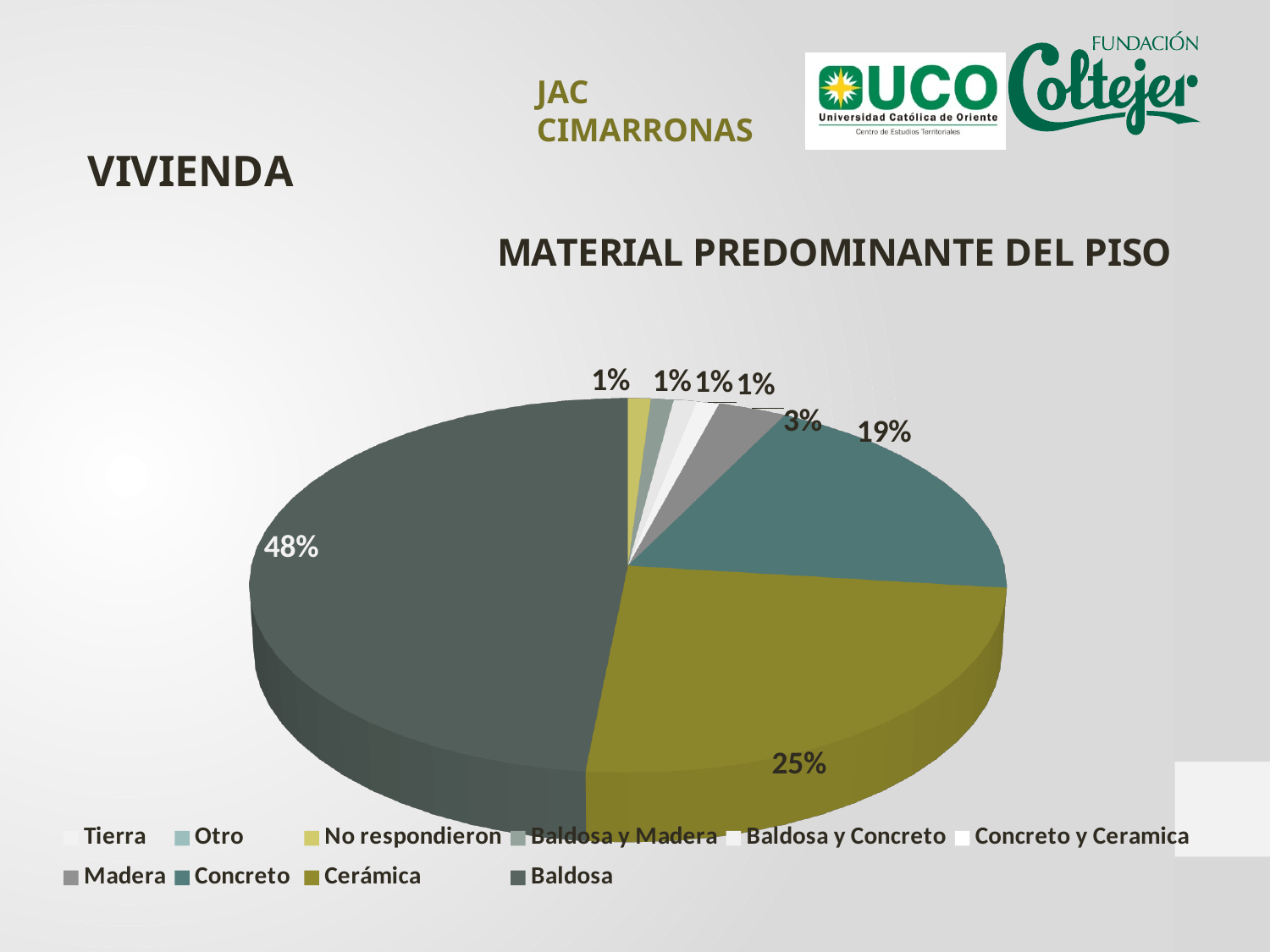
What kind of chart is shown on the slide? pie chart Which category has the largest slice of the pie? Baldosa What share of the pie does Madera account for? 3% What share of the pie does Concreto account for? 19% What is the difference in percentage points between the Baldosa slice and the Cerámica slice? 23 percentage points What share of the pie does Baldosa account for? 48% How many categories does the legend list? 10 What is the title of the chart? MATERIAL PREDOMINANTE DEL PISO What is the difference in percentage points between the Cerámica slice and the Concreto slice? 6 percentage points Which is larger, the slice for Concreto or the slice for Cerámica? Cerámica Is the share for Baldosa greater or less than 50%? less